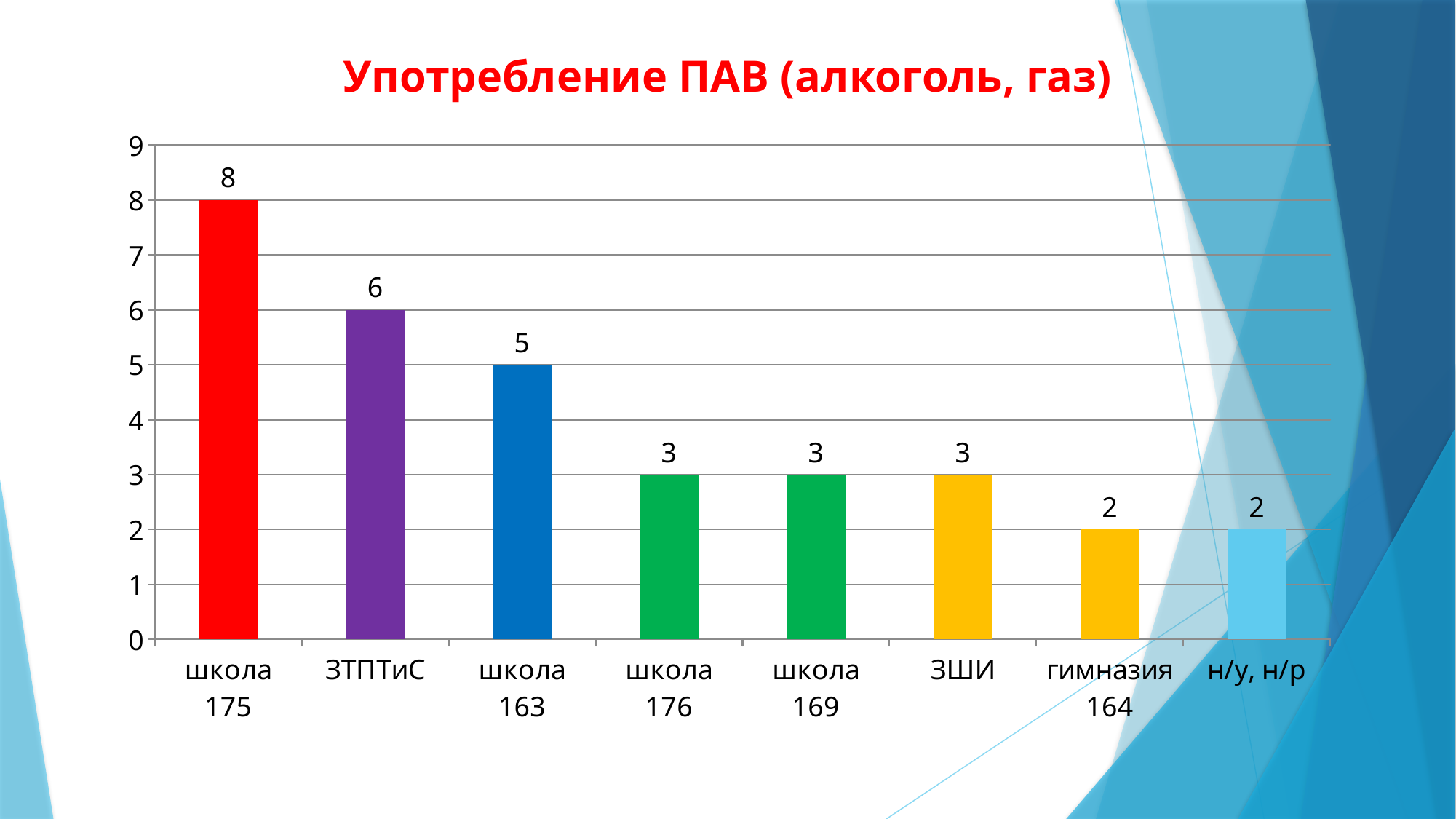
What is the value for гимназия 164? 2 Which is larger, the value for ЗТПТиС or the value for школа 176? ЗТПТиС What is the difference between the values for школа 175 and ЗТПТиС? 2 What is the title of the chart? Употребление ПАВ (алкоголь, газ) What is the value for школа 163? 5 How many categories are shown on the x axis? 8 Is the value for школа 175 greater or less than 7? greater Which category has the highest value? школа 175 What kind of chart is shown on the slide? bar chart What is the difference between the values for школа 163 and ЗШИ? 2 What is the value for школа 175? 8 What is the value for ЗТПТиС? 6